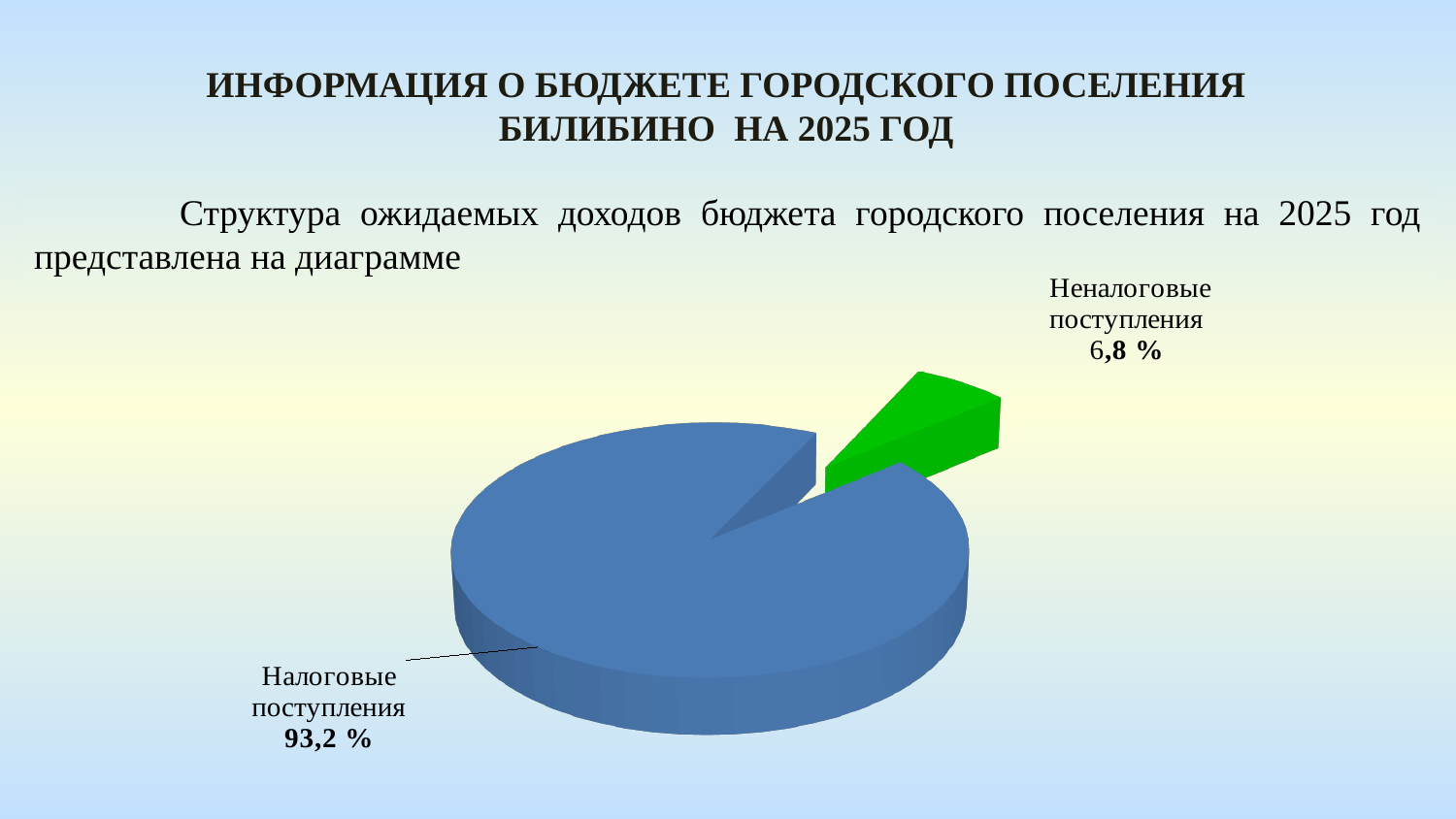
What share of the pie is labelled for Налоговые поступления? 93,2 % What colour is the slice for Неналоговые поступления? Green What kind of chart is shown on the slide? Pie chart Which is larger: the share for Налоговые поступления or the share for Неналоговые поступления? Налоговые поступления Which slice of the pie is the smallest? Неналоговые поступления Which slice of the pie is the largest? Налоговые поступления Is the share for Неналоговые поступления greater or less than 10 %? less What share of the pie is labelled for Неналоговые поступления? 6,8 % How many slices does the pie chart have? 2 Is the share for Налоговые поступления greater or less than 90 %? greater What is the difference in percentage points between Налоговые поступления and Неналоговые поступления? 86,4 What colour is the slice for Налоговые поступления? Blue